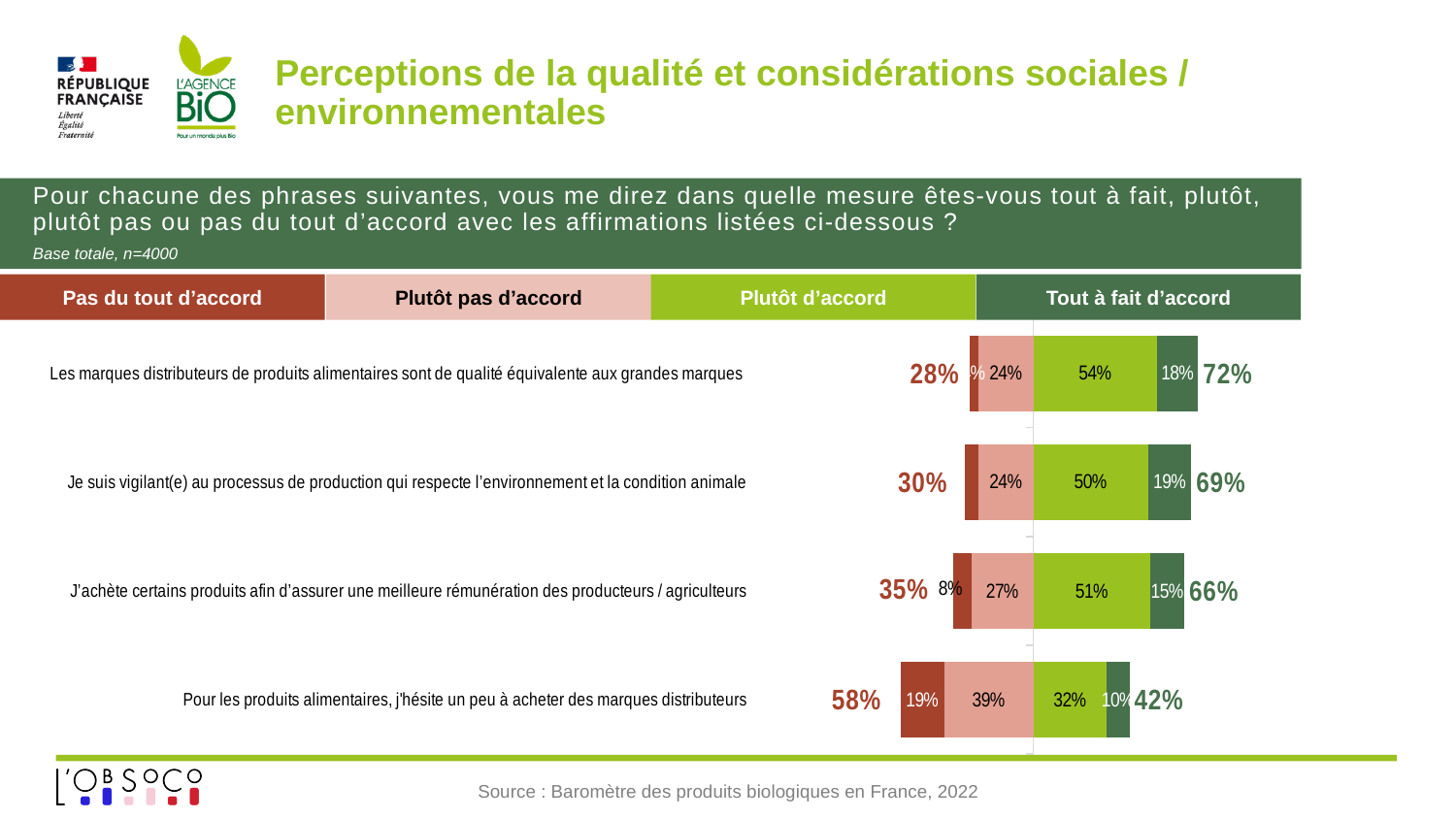
What percentage of respondents answered "Plutôt d'accord" to "Les marques distributeurs de produits alimentaires sont de qualité équivalente aux grandes marques"? 54% Which is larger: the "Tout à fait d'accord" value for "Je suis vigilant(e) au processus de production..." or for "J'achète certains produits afin d'assurer une meilleure rémunération des producteurs / agriculteurs"? Je suis vigilant(e) au processus de production qui respecte l'environnement et la condition animale What is the difference between the "Plutôt d'accord" values for "J'achète certains produits afin d'assurer une meilleure rémunération des producteurs / agriculteurs" and "Je suis vigilant(e) au processus de production qui respecte l'environnement et la condition animale"? 1% How many statements are plotted in the chart? 4 What is the "Pas du tout d'accord" value for "J'achète certains produits afin d'assurer une meilleure rémunération des producteurs / agriculteurs"? 8% Which statement has the lowest total agreement? Pour les produits alimentaires, j'hésite un peu à acheter des marques distributeurs How many response categories does the legend list? 4 What is the total agreement (Plutôt d'accord + Tout à fait d'accord) shown for "Les marques distributeurs de produits alimentaires sont de qualité équivalente aux grandes marques"? 72% Which statement has the highest total agreement? Les marques distributeurs de produits alimentaires sont de qualité équivalente aux grandes marques What is the total disagreement shown for "Pour les produits alimentaires, j'hésite un peu à acheter des marques distributeurs"? 58% What is the "Plutôt pas d'accord" value for "Pour les produits alimentaires, j'hésite un peu à acheter des marques distributeurs"? 39% What is the "Tout à fait d'accord" value for "Je suis vigilant(e) au processus de production qui respecte l'environnement et la condition animale"? 19%